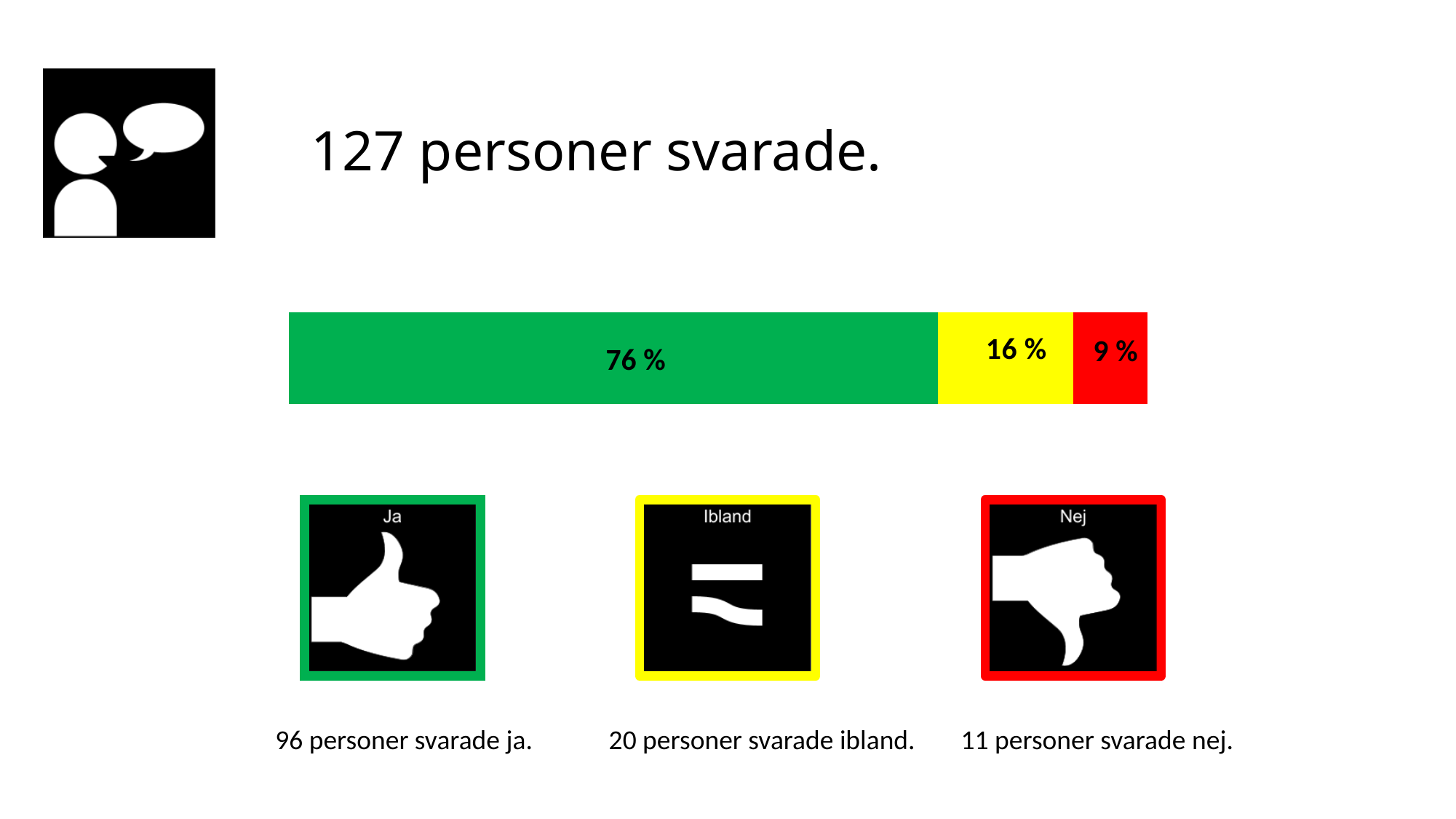
What is the difference in percentage points between the Ja segment and the Ibland segment? 60 Which response category has the smallest share of the bar? Nej How many people answered the survey in total, according to the slide title? 127 Which response category has the largest share of the bar? Ja What percentage is shown for the red segment (Nej) of the bar? 9 % What percentage is shown for the yellow segment (Ibland) of the bar? 16 % What kind of chart is shown on the slide? Stacked bar chart What colour is the segment representing Nej? Red Which segment is larger, Ibland or Nej? Ibland What is the difference in percentage points between the Ibland segment and the Nej segment? 7 What percentage is shown for the green segment (Ja) of the bar? 76 % How many segments does the stacked bar have? 3